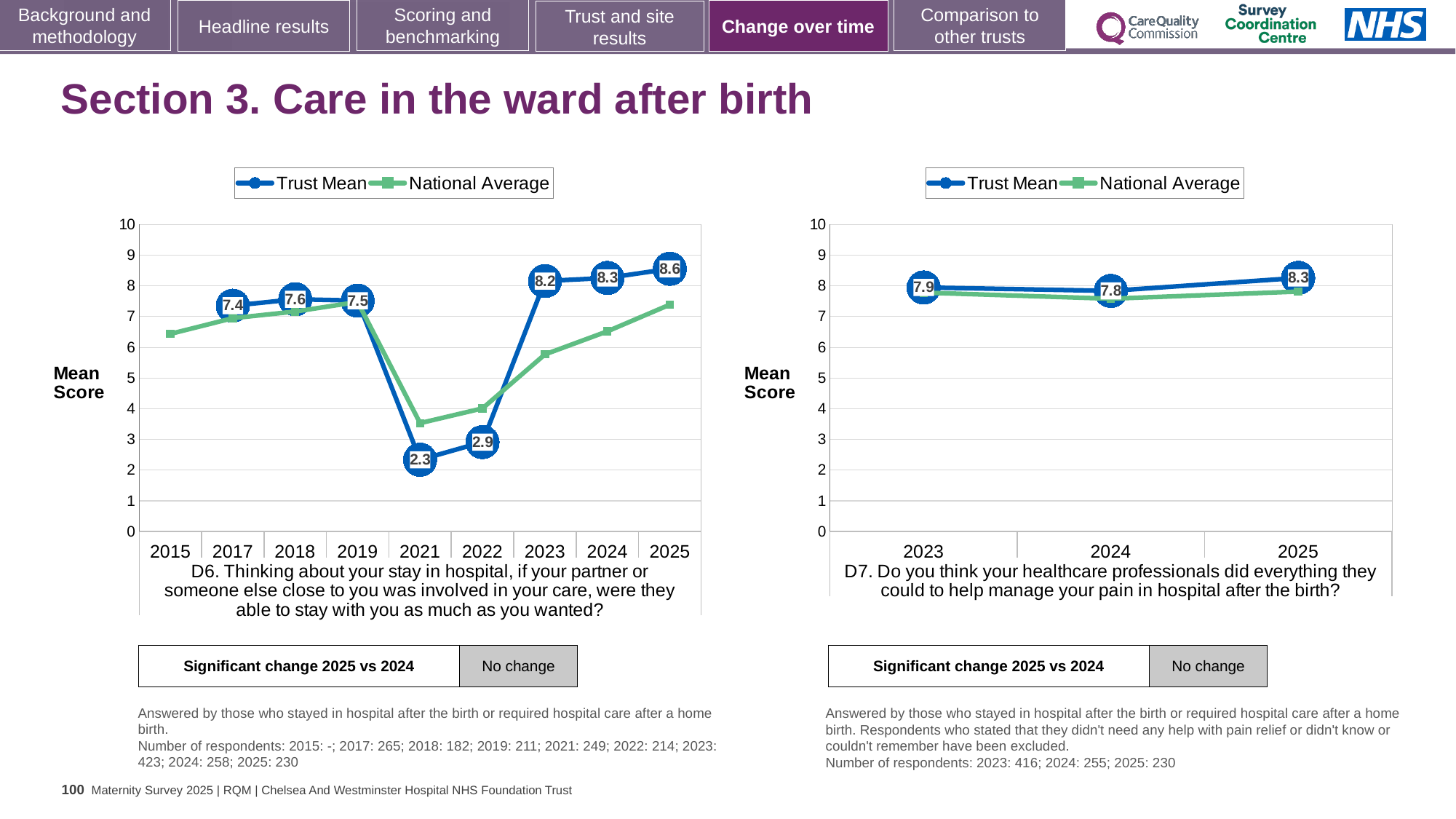
In the left chart (D6), what is the difference between the Trust Mean scores for 2025 and 2024? 0.3 In the left chart (D6), which year has the highest Trust Mean score? 2025 How many series does the legend of the left chart (D6) list? 2 In the left chart (D6), what is the Trust Mean score for 2021? 2.3 In the right chart (D7), what is the Trust Mean score for 2024? 7.8 In the left chart (D6), which year has the lowest Trust Mean score? 2021 In the left chart (D6), what is the Trust Mean score for 2025? 8.6 In the left chart (D6), is the Trust Mean score for 2022 greater or less than 3? less In the right chart (D7), which is larger, the Trust Mean for 2023 or for 2025? 2025 In the left chart (D6), is the National Average for 2015 greater or less than 6? greater In the right chart (D7), how many years are shown on the x axis? 3 What type of chart is the right chart (D7)? Line chart